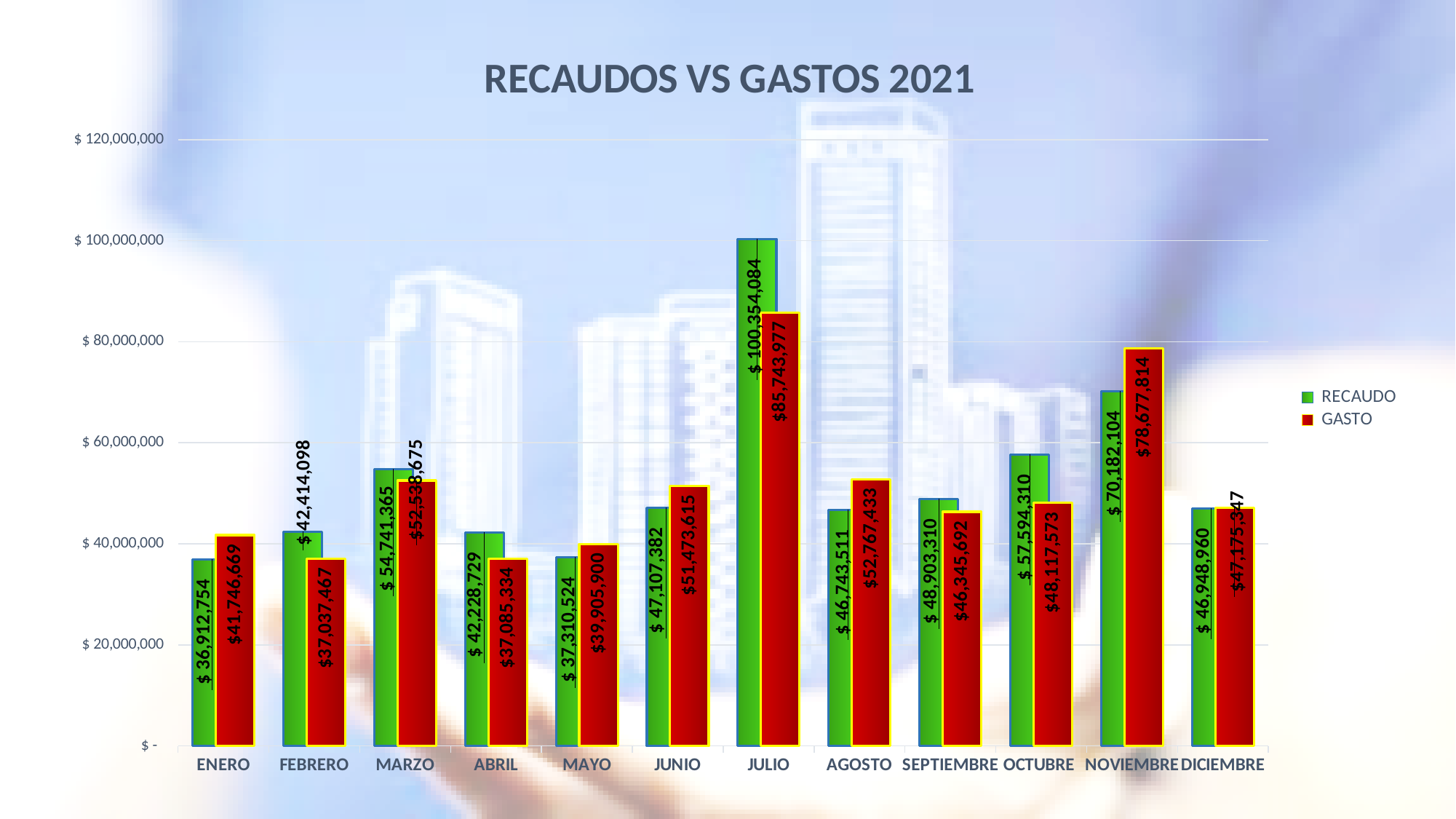
In OCTUBRE, which is larger, RECAUDO or GASTO? RECAUDO Which month has the highest GASTO value? JULIO What is the difference between RECAUDO and GASTO in JULIO? $14,610,107 What is the GASTO value for AGOSTO? $52,767,433 How many series does the legend list? 2 What is the RECAUDO value for MARZO? $ 54,741,365 What is the RECAUDO value for JULIO? $ 100,354,084 Is the RECAUDO value for NOVIEMBRE greater or less than $ 60,000,000? greater What is the GASTO value for NOVIEMBRE? $78,677,814 What type of chart is shown on the slide? Bar chart How many months are shown on the x axis? 12 Which month has the highest RECAUDO value? JULIO